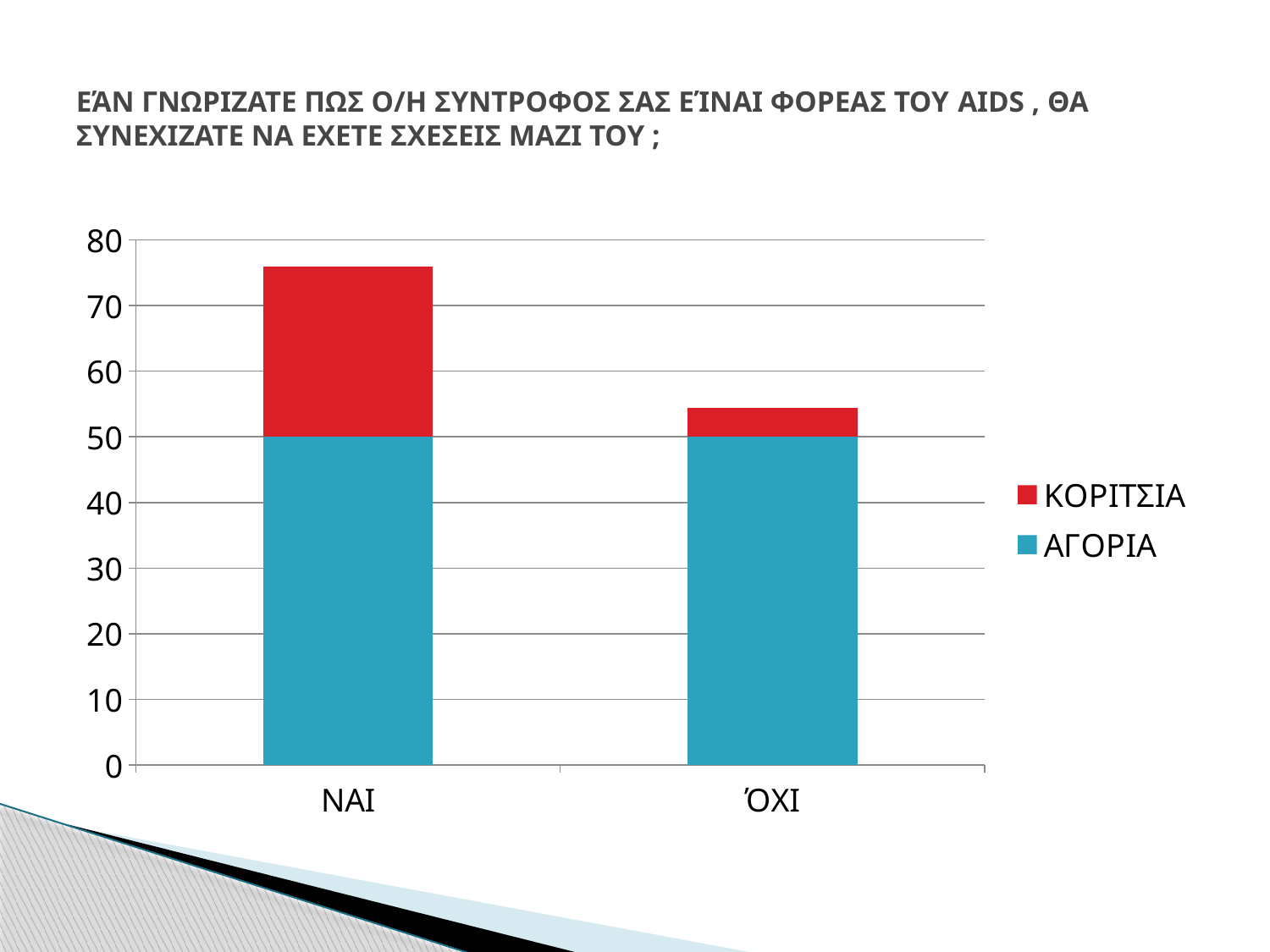
Is the total of the stacked bar for ΌΧΙ greater or less than 60? less How many categories are shown on the x axis? 2 Which category has the highest total stacked bar? ΝΑΙ Is the total of the stacked bar for ΝΑΙ greater or less than 70? greater What is the value of ΑΓΟΡΙΑ for ΌΧΙ? 50 Is the ΚΟΡΙΤΣΙΑ value for ΌΧΙ greater or less than 10? less Which category has the lowest total stacked bar? ΌΧΙ Which colour represents the ΚΟΡΙΤΣΙΑ series in the legend? red What kind of chart is shown on the slide? bar chart What is the value of ΑΓΟΡΙΑ for ΝΑΙ? 50 How many series does the legend list? 2 Which is larger, the ΚΟΡΙΤΣΙΑ value for ΝΑΙ or the ΚΟΡΙΤΣΙΑ value for ΌΧΙ? ΝΑΙ